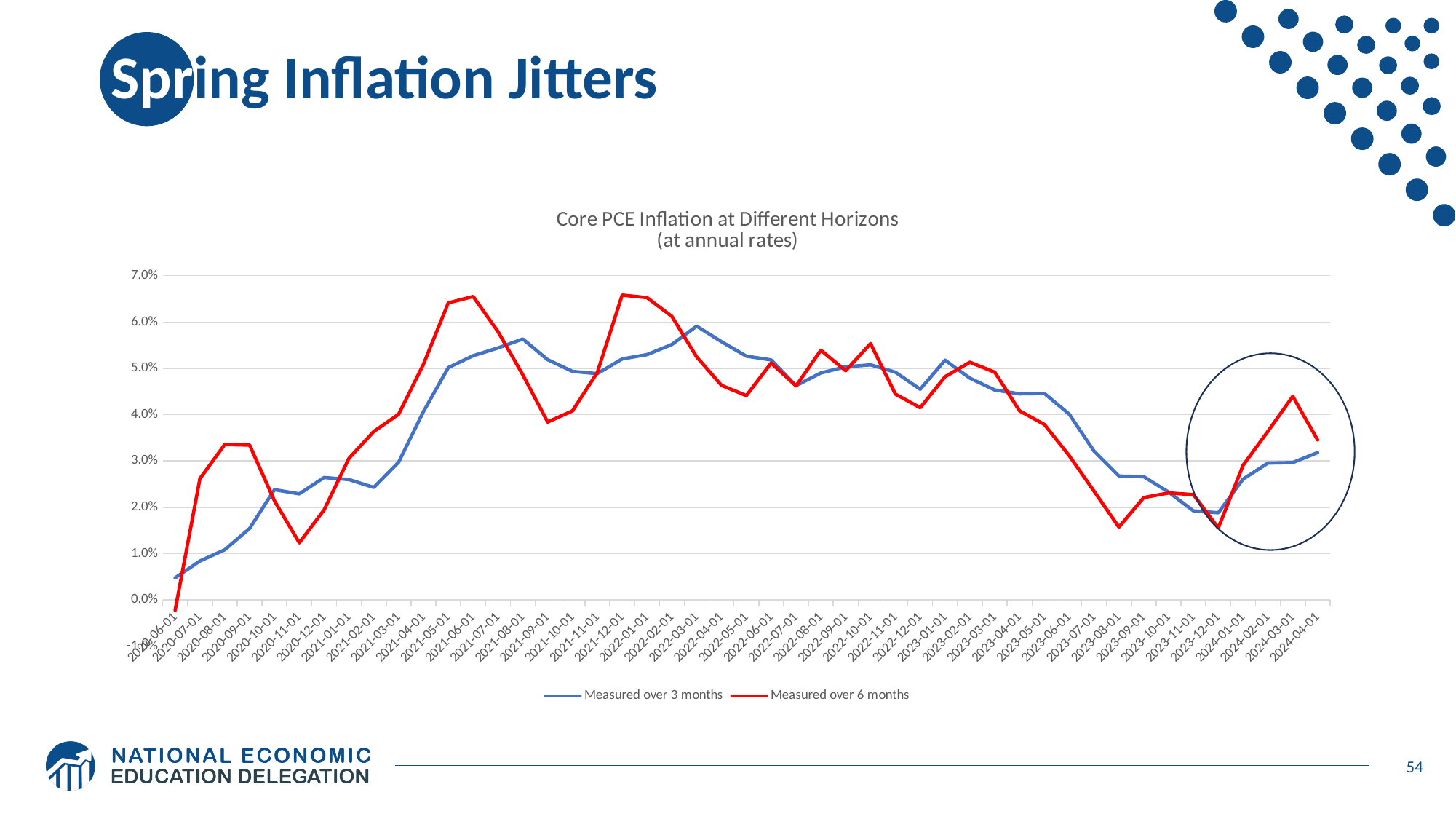
Is the value for 'Measured over 3 months' at 2024-04-01 greater or less than 3.0%? greater Is the value for 'Measured over 3 months' at 2021-08-01 greater or less than 5.0%? greater What kind of chart is shown on the slide? line chart What is the title of the chart? Core PCE Inflation at Different Horizons (at annual rates) Does the 'Measured over 6 months' series rise or fall from 2024-01-01 to 2024-03-01? rise At 2024-03-01, which series has the higher value, 'Measured over 3 months' or 'Measured over 6 months'? Measured over 6 months At which date does the 'Measured over 6 months' series reach its lowest value? 2020-06-01 Is the value for 'Measured over 6 months' at 2020-11-01 greater or less than 2.0%? less How many series does the chart legend list? 2 Which series is drawn in red? Measured over 6 months At 2020-11-01, which series has the higher value, 'Measured over 3 months' or 'Measured over 6 months'? Measured over 3 months